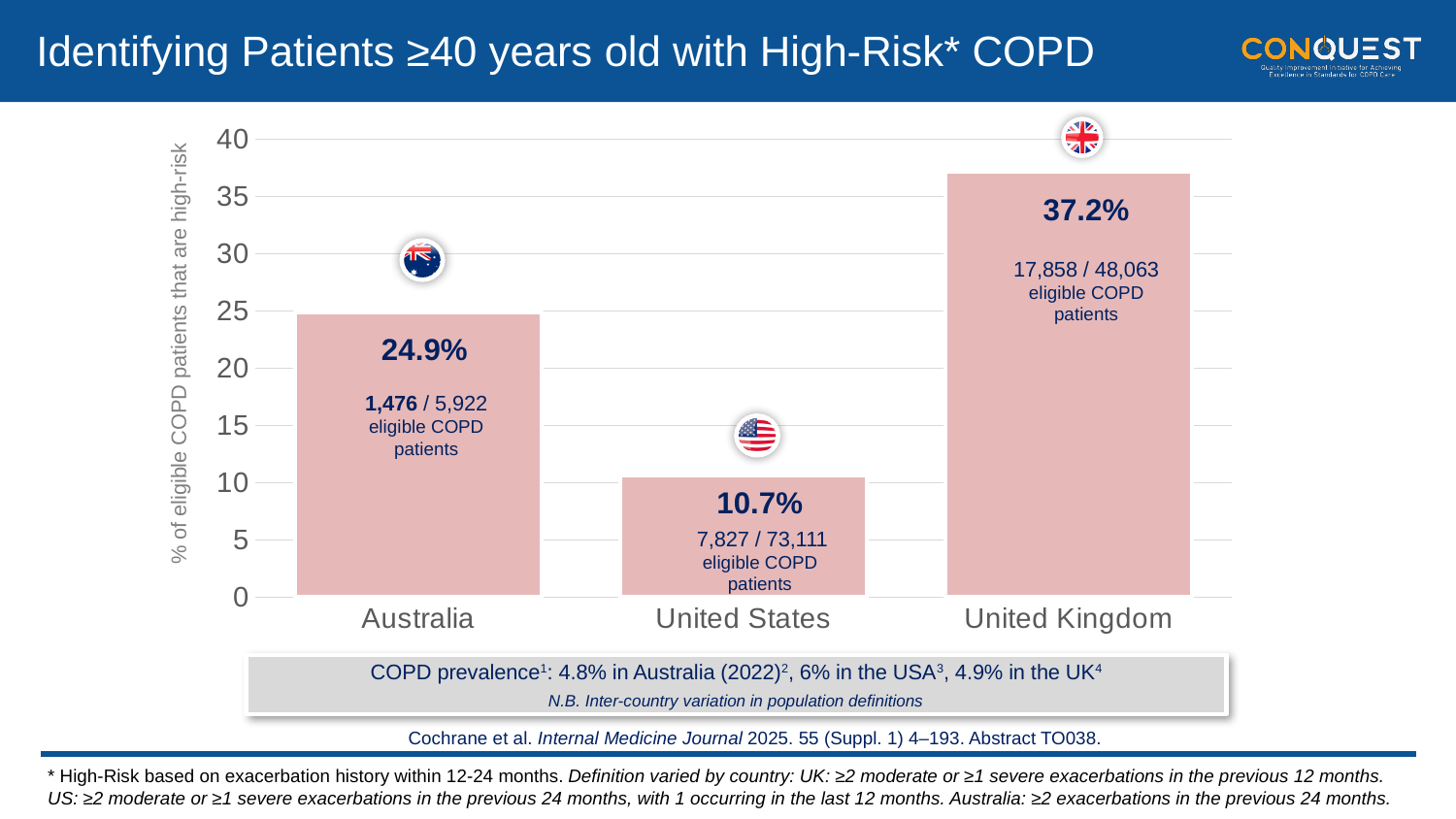
What kind of chart is shown on the slide? Bar chart How many eligible COPD patients were there in the United Kingdom? 48,063 Which country has the highest percentage of eligible COPD patients that are high-risk? United Kingdom Which country has the lowest percentage of eligible COPD patients that are high-risk? United States How many countries are shown on the chart? 3 What is the value for the United States? 10.7% What is the difference between the Australia and United States values? 14.2% What is the value for Australia? 24.9% What is the value for the United Kingdom? 37.2% What is the difference between the United Kingdom and Australia values? 12.3% Which is larger, the value for Australia or the value for the United States? Australia What is the label of the y axis? % of eligible COPD patients that are high-risk